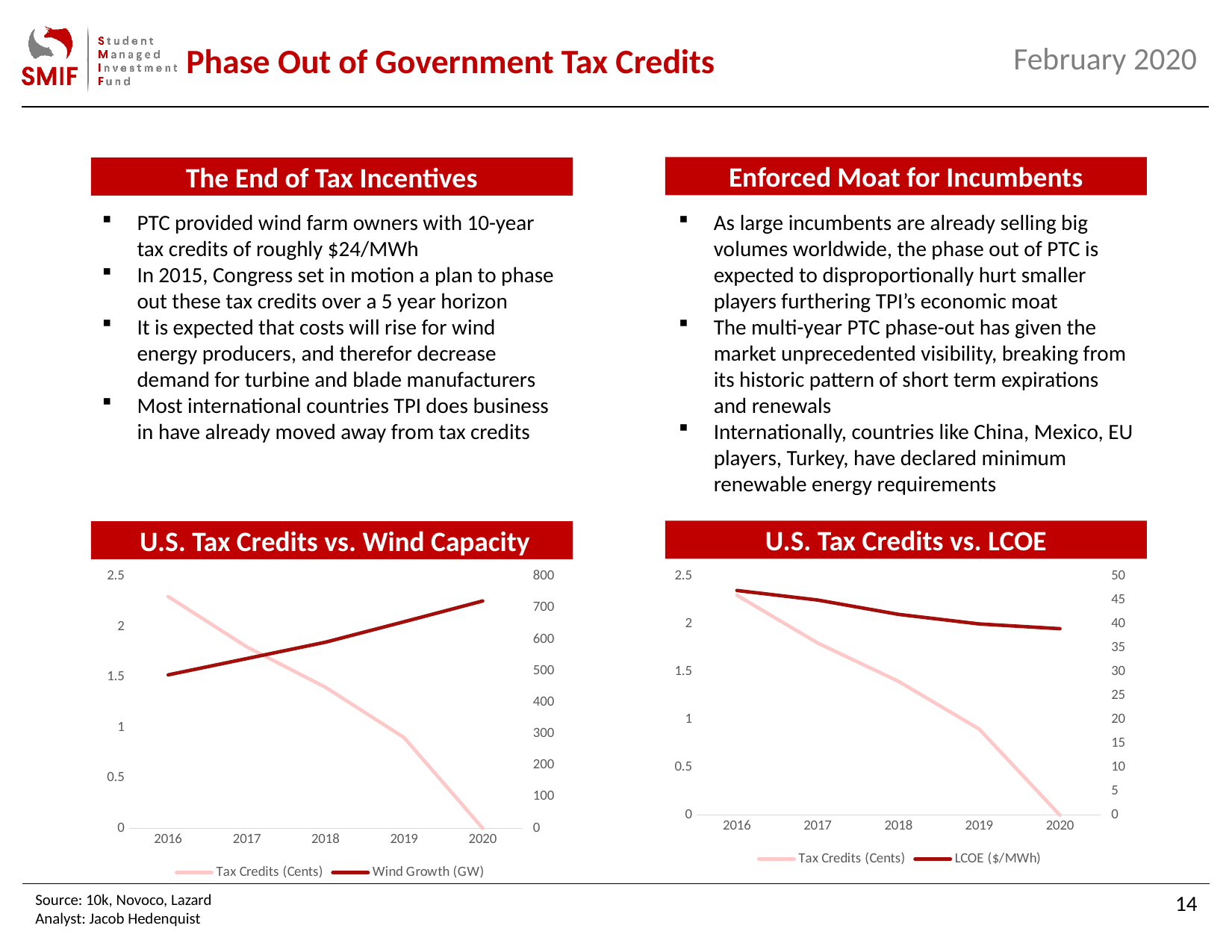
In 'U.S. Tax Credits vs. LCOE', which year has the lowest Tax Credits (Cents) value? 2020 How many years are plotted along the x axis of 'U.S. Tax Credits vs. Wind Capacity'? 5 What are the two series named in the legend of 'U.S. Tax Credits vs. Wind Capacity'? Tax Credits (Cents) and Wind Growth (GW) What kind of chart is 'U.S. Tax Credits vs. Wind Capacity'? line chart In 'U.S. Tax Credits vs. LCOE', does the Tax Credits (Cents) line rise or fall from 2016 to 2020? fall In 'U.S. Tax Credits vs. Wind Capacity', does the Wind Growth (GW) line rise or fall from 2016 to 2020? rise In 'U.S. Tax Credits vs. LCOE', is the LCOE ($/MWh) value for 2016 greater or less than 40? greater In 'U.S. Tax Credits vs. LCOE', does the LCOE ($/MWh) line rise or fall over the period shown? fall How many series does the legend of 'U.S. Tax Credits vs. LCOE' list? 2 In 'U.S. Tax Credits vs. Wind Capacity', is the Tax Credits (Cents) value for 2016 greater or less than 2? greater In 'U.S. Tax Credits vs. Wind Capacity', is the Wind Growth (GW) value for 2019 greater or less than 600? greater In 'U.S. Tax Credits vs. Wind Capacity', which year has the higher Tax Credits (Cents) value, 2016 or 2019? 2016